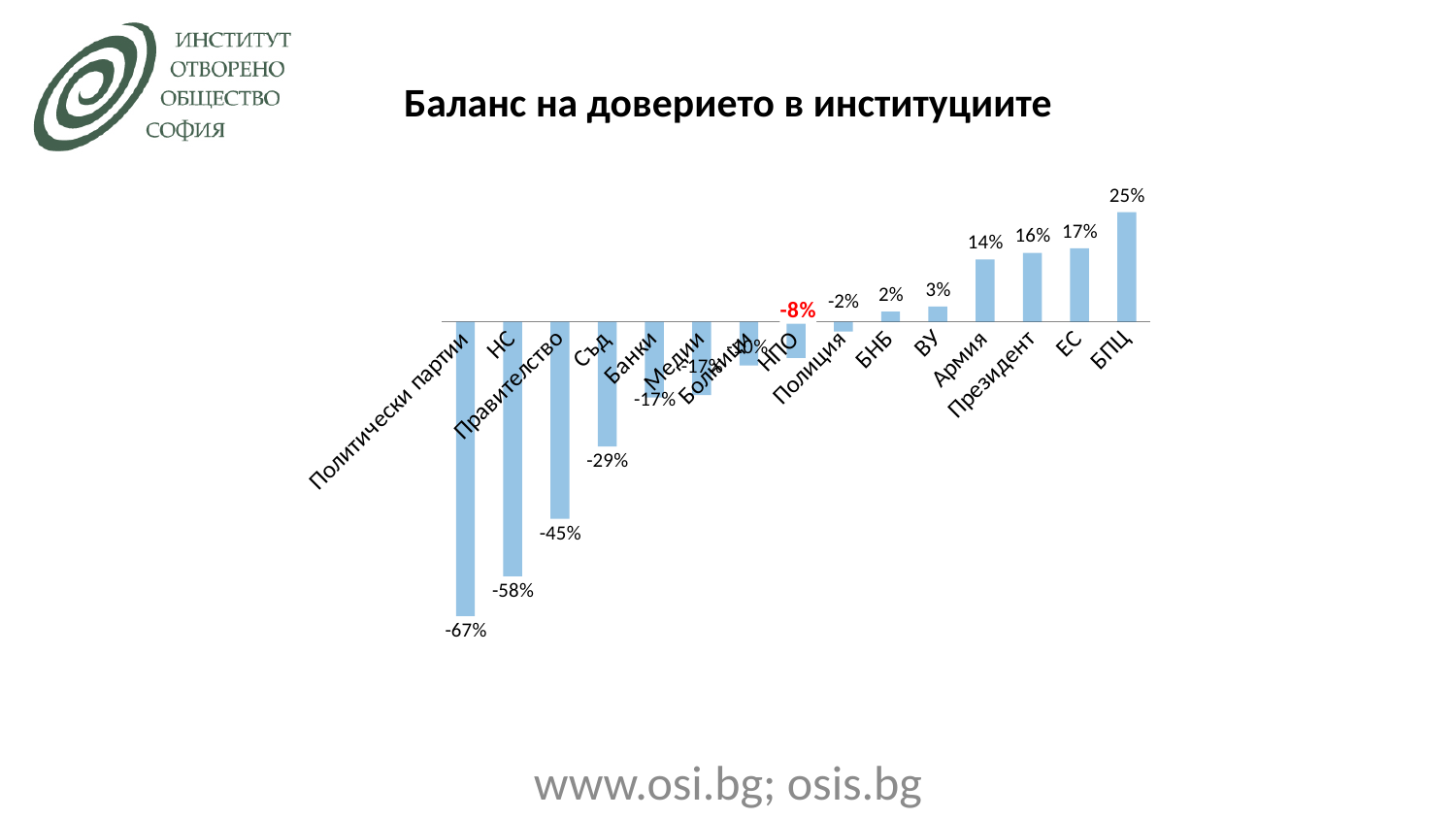
What is the value for Политически партии? -67% What is the value for Правителство? -45% What is the value for НПО? -8% What is the value for НС? -58% Which category has the highest value? БПЦ What kind of chart is shown on the slide? bar chart Do the values rise or fall from left to right along the x axis? rise Which has a larger value, Армия or Президент? Президент What is the value for Съд? -29% What is the difference between the values for БПЦ and ЕС? 8 percentage points Which category has the lowest value? Политически партии What is the value for БПЦ? 25%